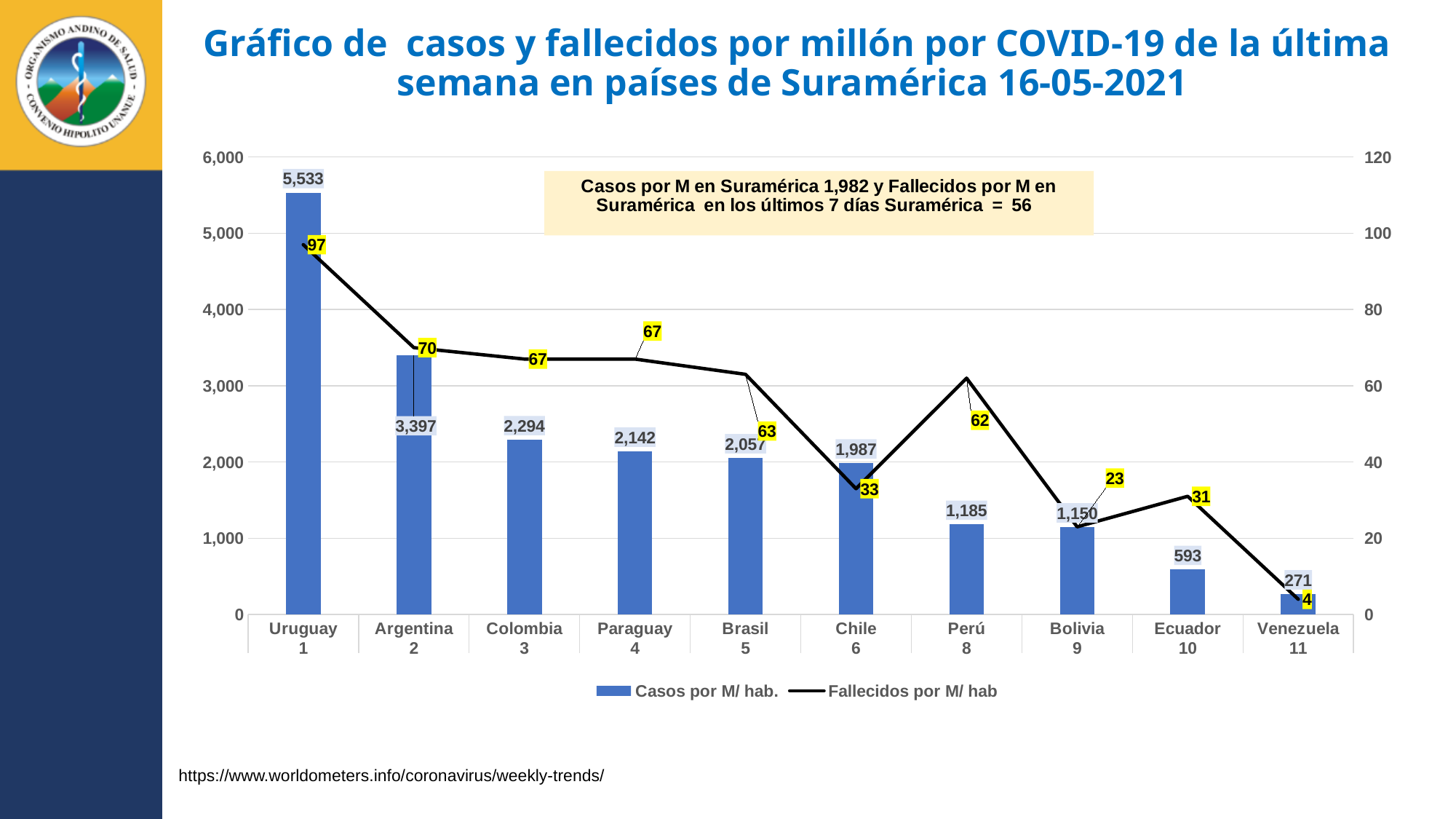
Which country has the highest value of Fallecidos por M/ hab? Uruguay How many countries are shown on the x axis? 10 What kind of chart is used to show Casos por M/ hab.? Bar chart What is the value of Casos por M/ hab. for Uruguay? 5,533 What is the value of Casos por M/ hab. for Ecuador? 593 What is the value of Fallecidos por M/ hab for Venezuela? 4 What is the difference in Casos por M/ hab. between Uruguay and Argentina? 2,136 Which country has the lowest value of Casos por M/ hab.? Venezuela What is the value of Fallecidos por M/ hab for Chile? 33 How many series does the legend list? 2 Which has a higher value of Fallecidos por M/ hab, Perú or Bolivia? Perú Do the Casos por M/ hab. values rise or fall from Uruguay to Venezuela along the x axis? Fall